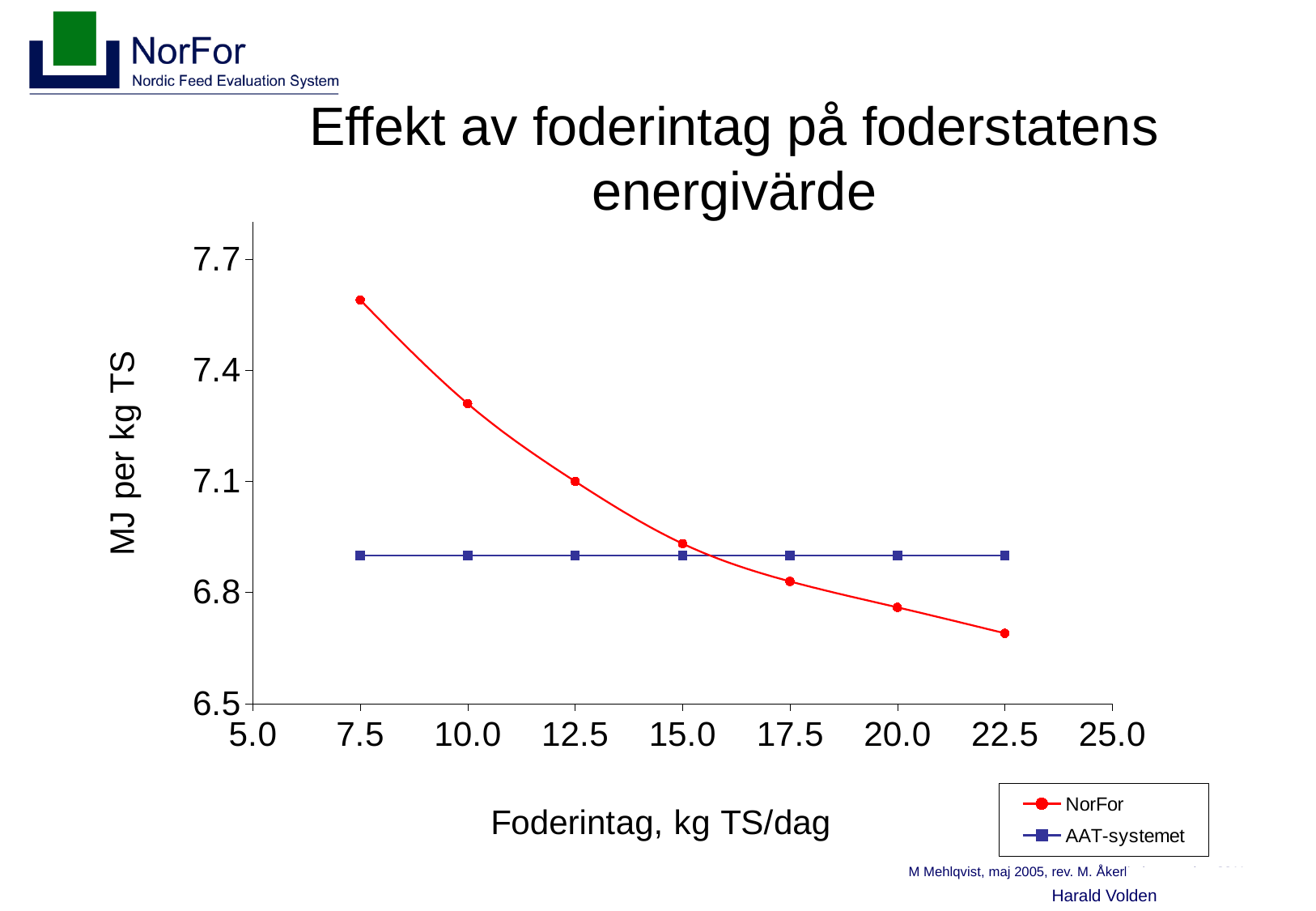
Is the NorFor value at 22.5 kg TS/dag greater or less than 6.8? less How many series does the legend list? 2 Does the NorFor series rise or fall as feed intake increases? fall At a feed intake of 22.5 kg TS/dag, which series has the higher value, NorFor or AAT-systemet? AAT-systemet Is the AAT-systemet value at 15.0 kg TS/dag greater or less than 6.8? greater What kind of chart is shown on the slide? line chart At which feed intake does the NorFor series reach its highest value? 7.5 How many data points are plotted for the NorFor series? 7 Is the NorFor value at 7.5 kg TS/dag greater or less than 7.4? greater At a feed intake of 7.5 kg TS/dag, which series has the higher value, NorFor or AAT-systemet? NorFor What is the value of the NorFor series at a feed intake of 12.5 kg TS/dag? 7.1